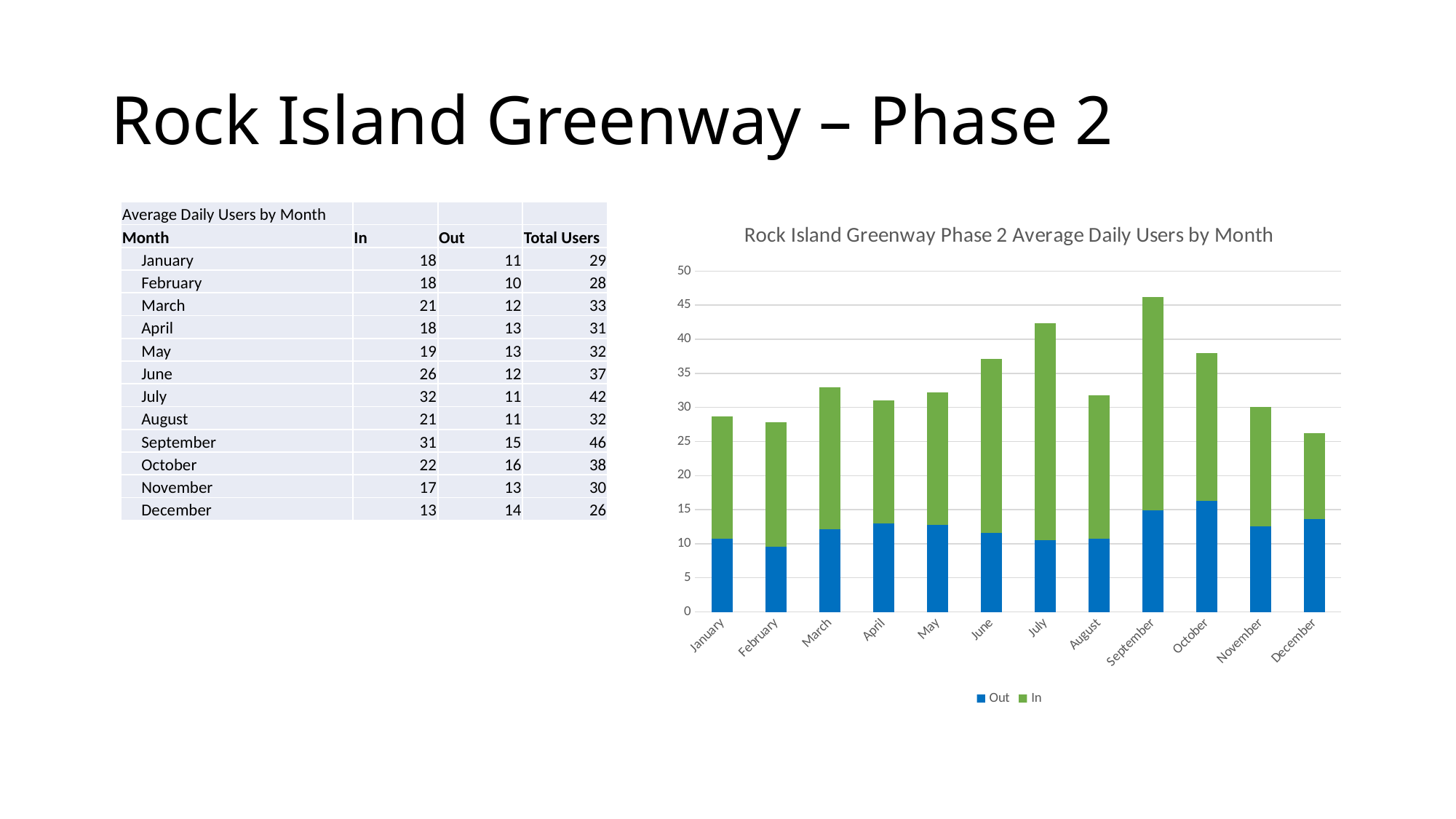
What is the total of the stacked bar for September? 46 Which month has the lowest total average daily users? December Is the total value for September greater or less than 45? greater What colour represents the Out series in the chart? blue Which month has the highest total average daily users? September How many series does the chart legend list? 2 What is the In value for July? 32 What is the Out value for October? 16 What is the difference between the In value for July and the In value for January? 14 How many months are plotted along the x axis of the chart? 12 What kind of chart is shown on the slide? bar chart Which month has the larger total users, June or August? June